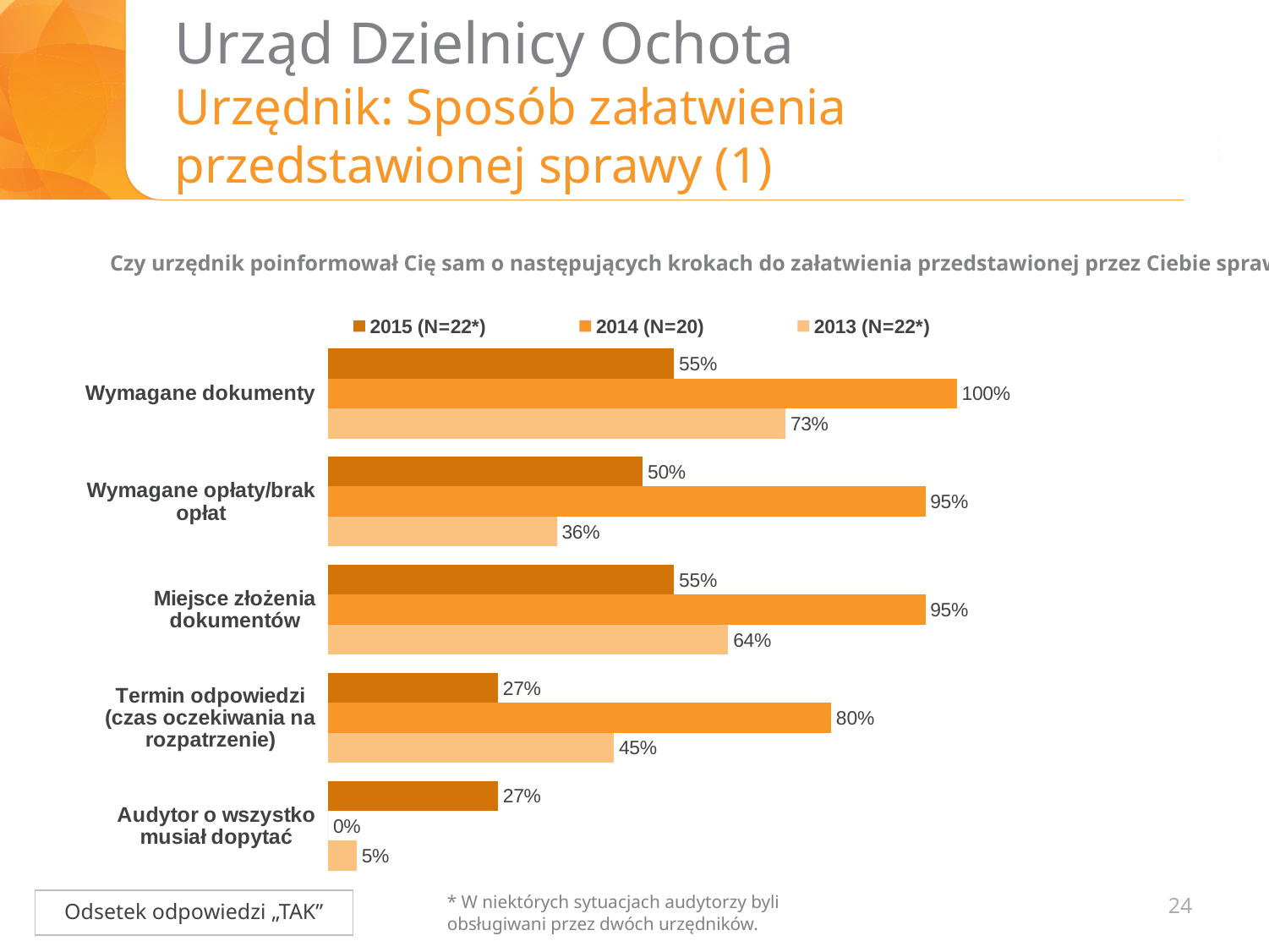
What is the difference between the 2014 (N=20) and 2015 (N=22*) values for "Wymagane dokumenty"? 45% Which category has the lowest value in the 2014 (N=20) series? Audytor o wszystko musiał dopytać How many series does the legend list? 3 How many categories are shown on the chart? 5 Which category has the highest value in the 2013 (N=22*) series? Wymagane dokumenty What is the value for "Wymagane opłaty/brak opłat" in the 2013 (N=22*) series? 36% What is the value for "Audytor o wszystko musiał dopytać" in the 2014 (N=20) series? 0% What is the difference between the 2013 (N=22*) and 2015 (N=22*) values for "Termin odpowiedzi (czas oczekiwania na rozpatrzenie)"? 18% What kind of chart is shown on the slide? Bar chart What is the value for "Termin odpowiedzi (czas oczekiwania na rozpatrzenie)" in the 2015 (N=22*) series? 27% For "Miejsce złożenia dokumentów", which is larger: the 2015 (N=22*) value or the 2013 (N=22*) value? 2013 (N=22*) What is the value for "Wymagane dokumenty" in the 2014 (N=20) series? 100%